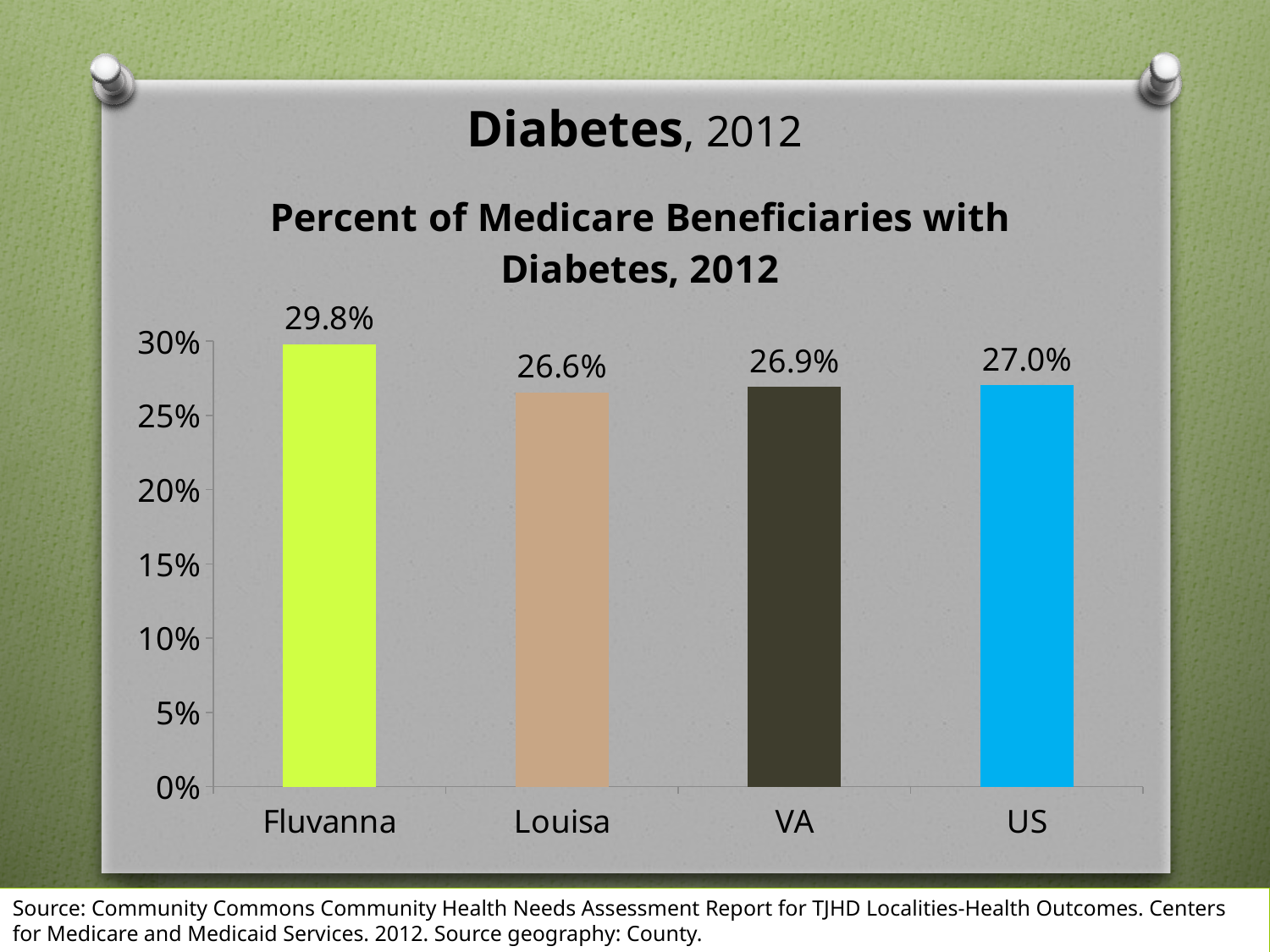
How many categories are shown on the x axis? 4 What is the percent of Medicare beneficiaries with diabetes in Louisa? 26.6% What is the difference between the US and VA values? 0.1% Is the value for Fluvanna greater or less than 25%? greater What is the title of the chart? Percent of Medicare Beneficiaries with Diabetes, 2012 What is the percent of Medicare beneficiaries with diabetes for the US? 27.0% What is the percent of Medicare beneficiaries with diabetes in Fluvanna? 29.8% What is the difference between the Fluvanna and Louisa values? 3.2% What is the percent of Medicare beneficiaries with diabetes for VA? 26.9% Which category has the lowest percent of Medicare beneficiaries with diabetes? Louisa Which category has the highest percent of Medicare beneficiaries with diabetes? Fluvanna What kind of chart is shown on the slide? Bar chart